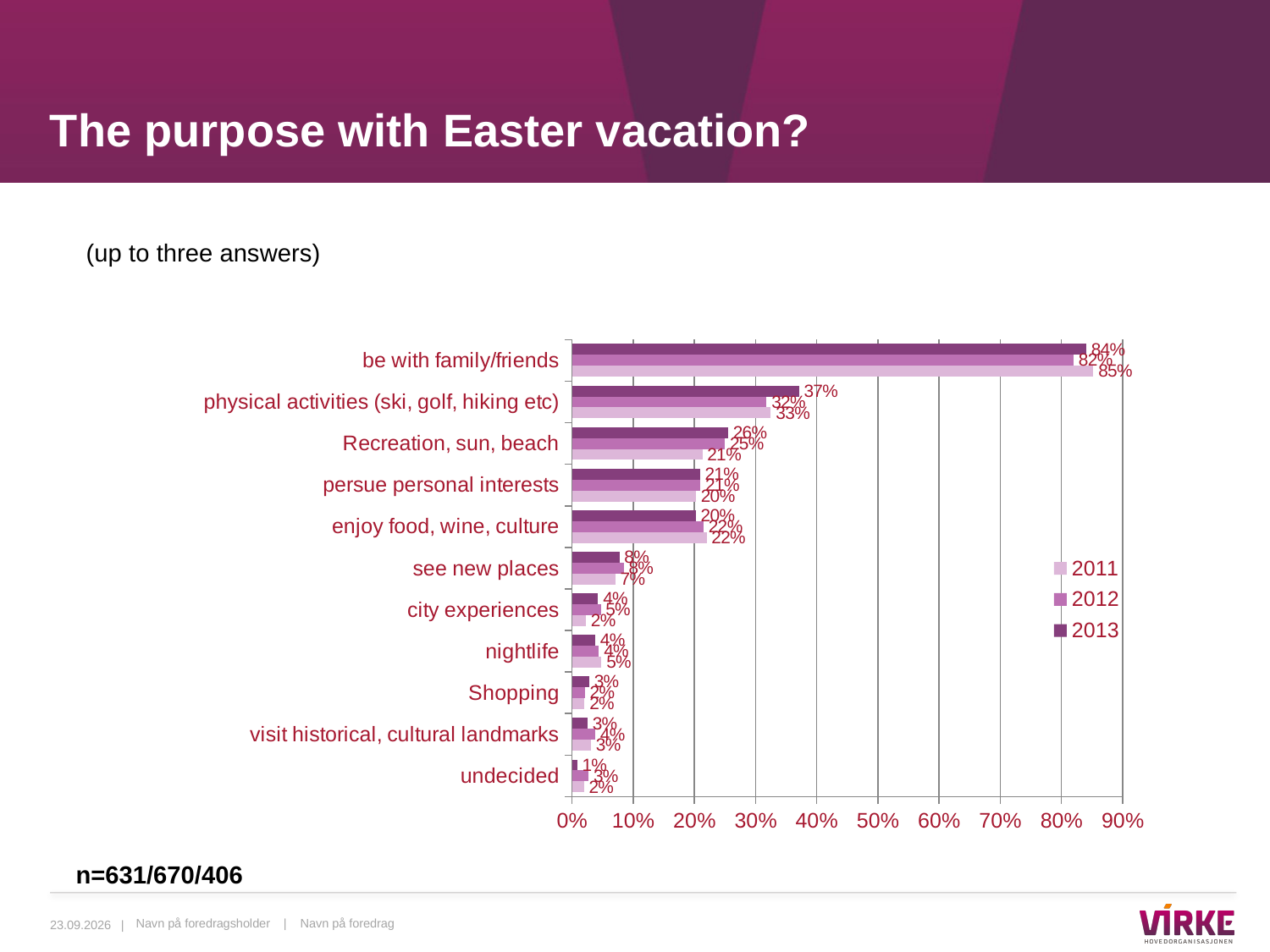
What is the 2013 value for physical activities (ski, golf, hiking etc)? 37% How many categories are shown on the chart? 11 Which category has the highest value in 2013? be with family/friends Which legend entry is shown with the darkest colour? 2013 What kind of chart is shown on the slide? bar chart What is the 2013 value for be with family/friends? 84% What is the difference between the 2013 and 2011 values for physical activities (ski, golf, hiking etc)? 4% What is the 2011 value for be with family/friends? 85% Which category has the lowest value in 2013? undecided What is the 2011 value for Recreation, sun, beach? 21% Which is larger for Recreation, sun, beach: the 2013 value or the 2011 value? 2013 How many series does the legend list? 3